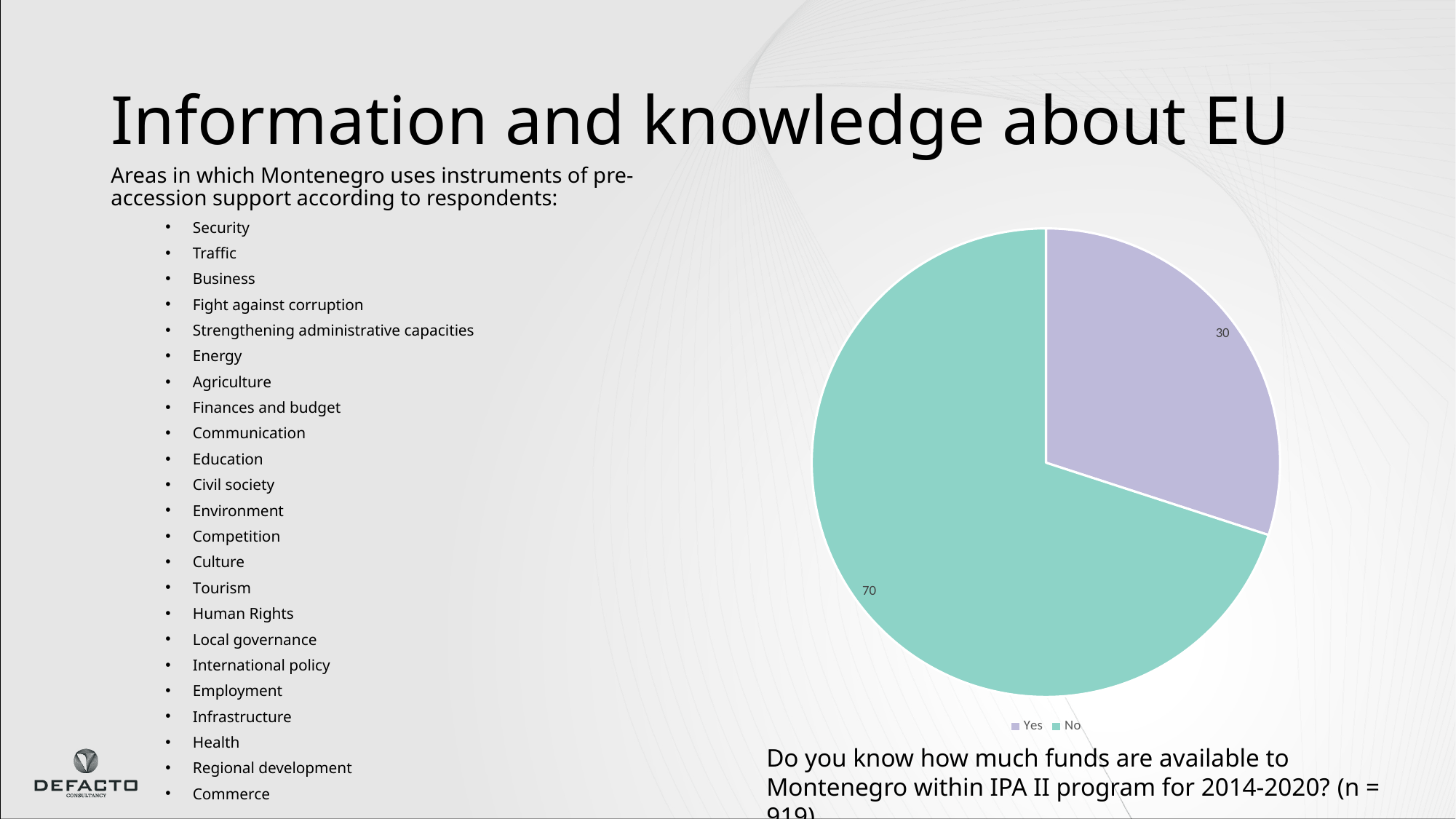
Which slice of the pie chart is the largest? No What question does the pie chart answer, according to the caption below it? Do you know how much funds are available to Montenegro within IPA II program for 2014-2020? How many entries does the pie chart legend list? 2 What colour is the Yes slice in the pie chart? purple What share of the pie does the No slice represent? 70% What is the value for Yes in the pie chart? 30 How many slices does the pie chart have? 2 What kind of chart is shown on the slide? pie chart What is the value for No in the pie chart? 70 What is the difference between the No and Yes values in the pie chart? 40 Which is larger in the pie chart, Yes or No? No Which slice of the pie chart is the smallest? Yes